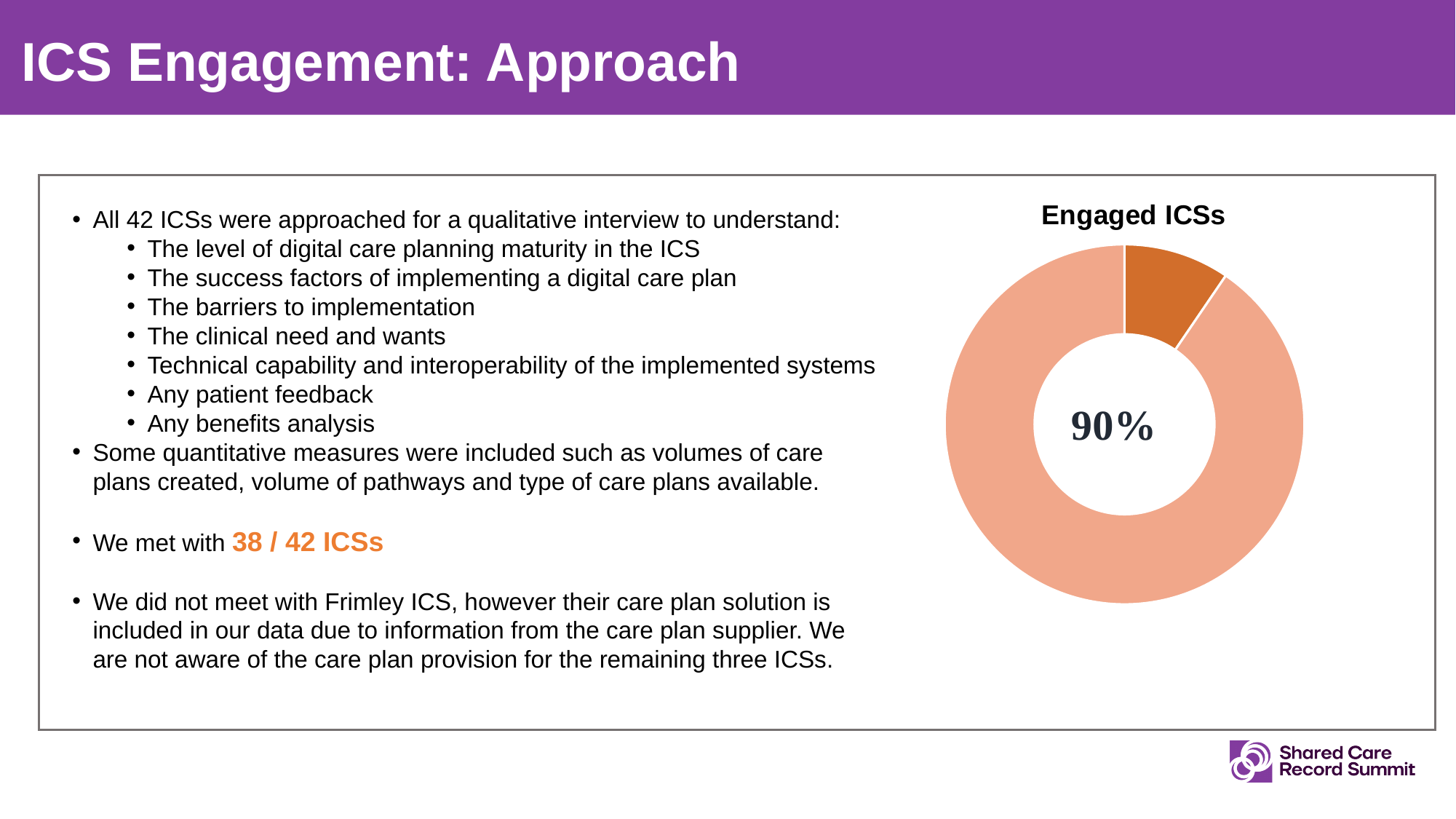
What kind of chart is shown on the slide? Pie chart (donut) What is the title of the chart on the slide? Engaged ICSs In the Engaged ICSs chart, which slice is larger, the light orange slice or the dark orange slice? The light orange slice How many slices does the Engaged ICSs chart have? 2 What share of the Engaged ICSs chart does the large light orange slice represent? 90% Does the Engaged ICSs chart show a legend? No What percentage is printed in the centre of the Engaged ICSs chart? 90%